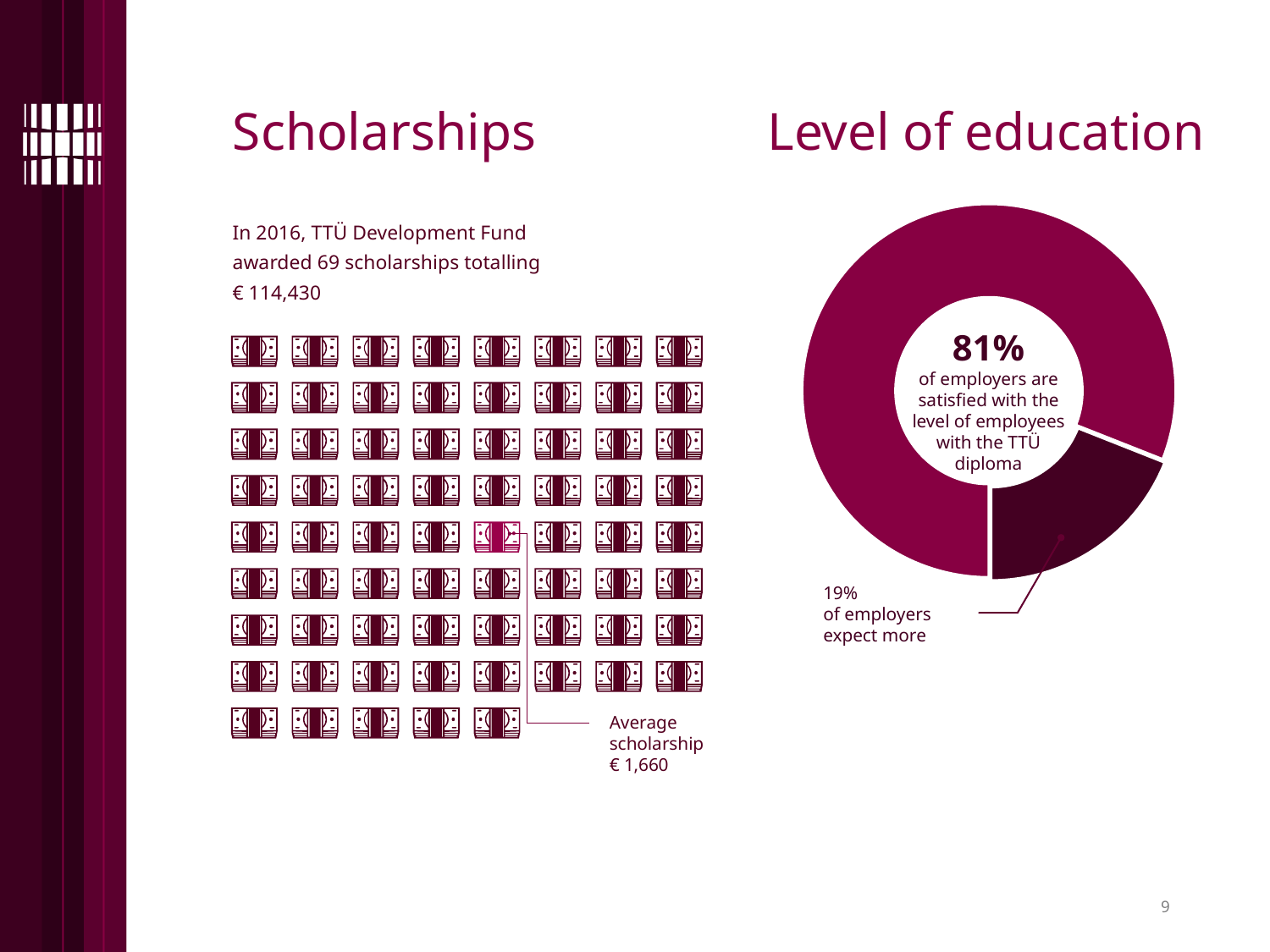
On the Level of education chart, what is the difference in percentage points between employers who are satisfied and employers who expect more? 62 percentage points On the Level of education chart, what percentage of employers expect more? 19% On the Level of education chart, which slice is the largest? employers satisfied with the level of employees with the TTÜ diploma (81%) On the Level of education chart, how many slices does the pie have? 2 What is the title of the chart on the right side of the slide? Level of education On the Level of education chart, do the two slices add up to 100%? Yes, 81% + 19% = 100% In the Scholarships pictogram, how many scholarships did the TTÜ Development Fund award in 2016? 69 On the Level of education chart, which is larger: the share of employers who are satisfied or the share who expect more? employers who are satisfied In the Scholarships pictogram, what is the average scholarship amount shown? € 1,660 On the Level of education chart, what percentage of employers are satisfied with the level of employees with the TTÜ diploma? 81% On the Level of education chart, which slice is the smallest? employers who expect more (19%) On the Level of education chart, what kind of chart is shown? pie chart (donut)